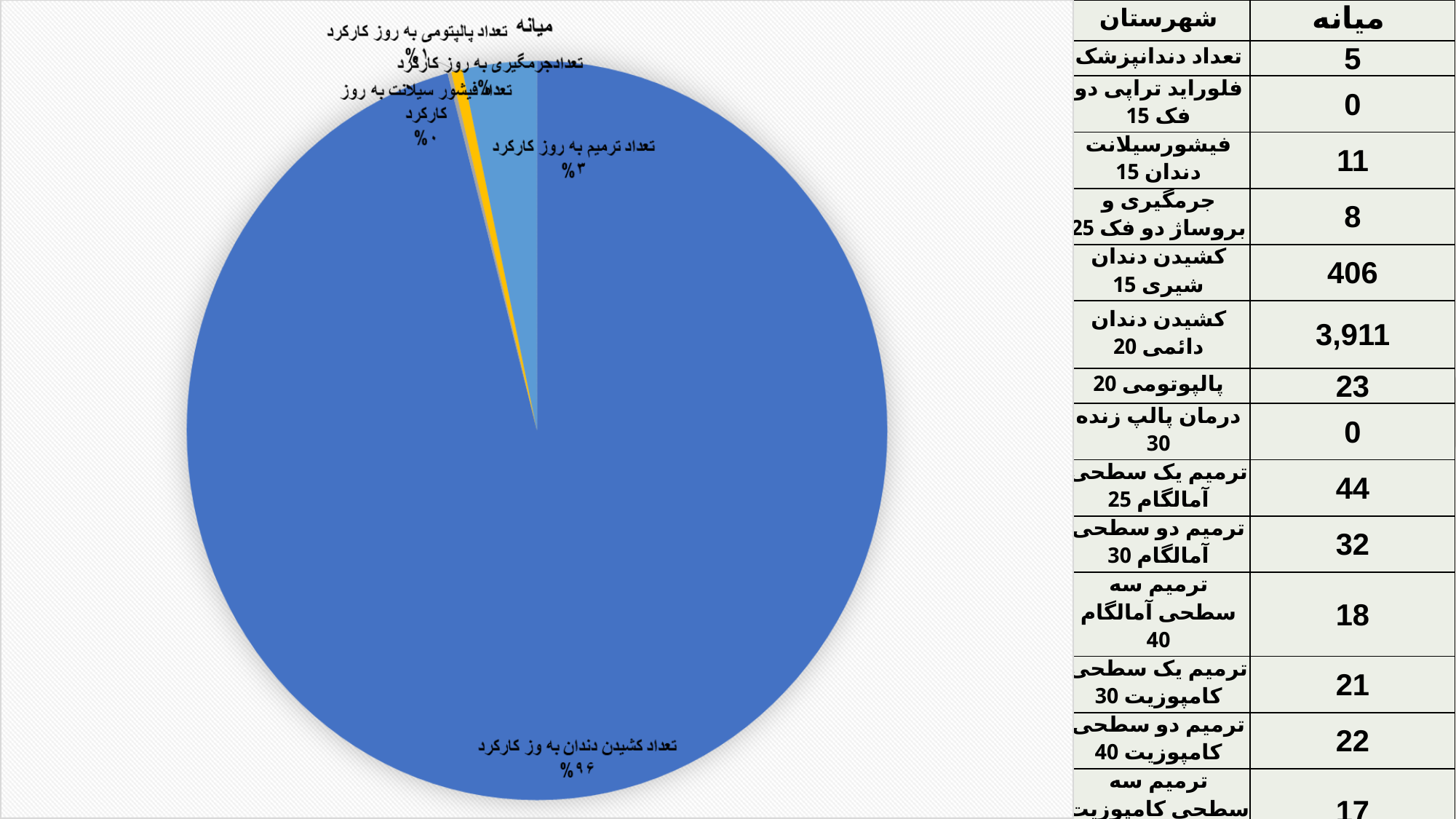
What is the title of the pie chart? میانه Is the share for "تعداد کشیدن دندان به روز کارکرد" greater or less than 50%? greater Which is larger, the slice for "تعداد کشیدن دندان به روز کارکرد" or the slice for "تعداد ترمیم به روز کارکرد"? تعداد کشیدن دندان به روز کارکرد What colour is the largest slice of the pie chart? blue Which category has the largest slice of the pie? تعداد کشیدن دندان به روز کارکرد What share of the pie does "تعداد کشیدن دندان به روز کارکرد" have? ۹۶% What percentage is shown for "تعداد فیشور سیلانت به روز کارکرد"? ۰% What kind of chart is shown on the slide? pie chart How many categories are labelled on the pie chart? 5 What is the difference in percentage points between the "تعداد کشیدن دندان به روز کارکرد" slice and the "تعداد ترمیم به روز کارکرد" slice? ۹۳% What share of the pie does "تعداد ترمیم به روز کارکرد" have? ۳%